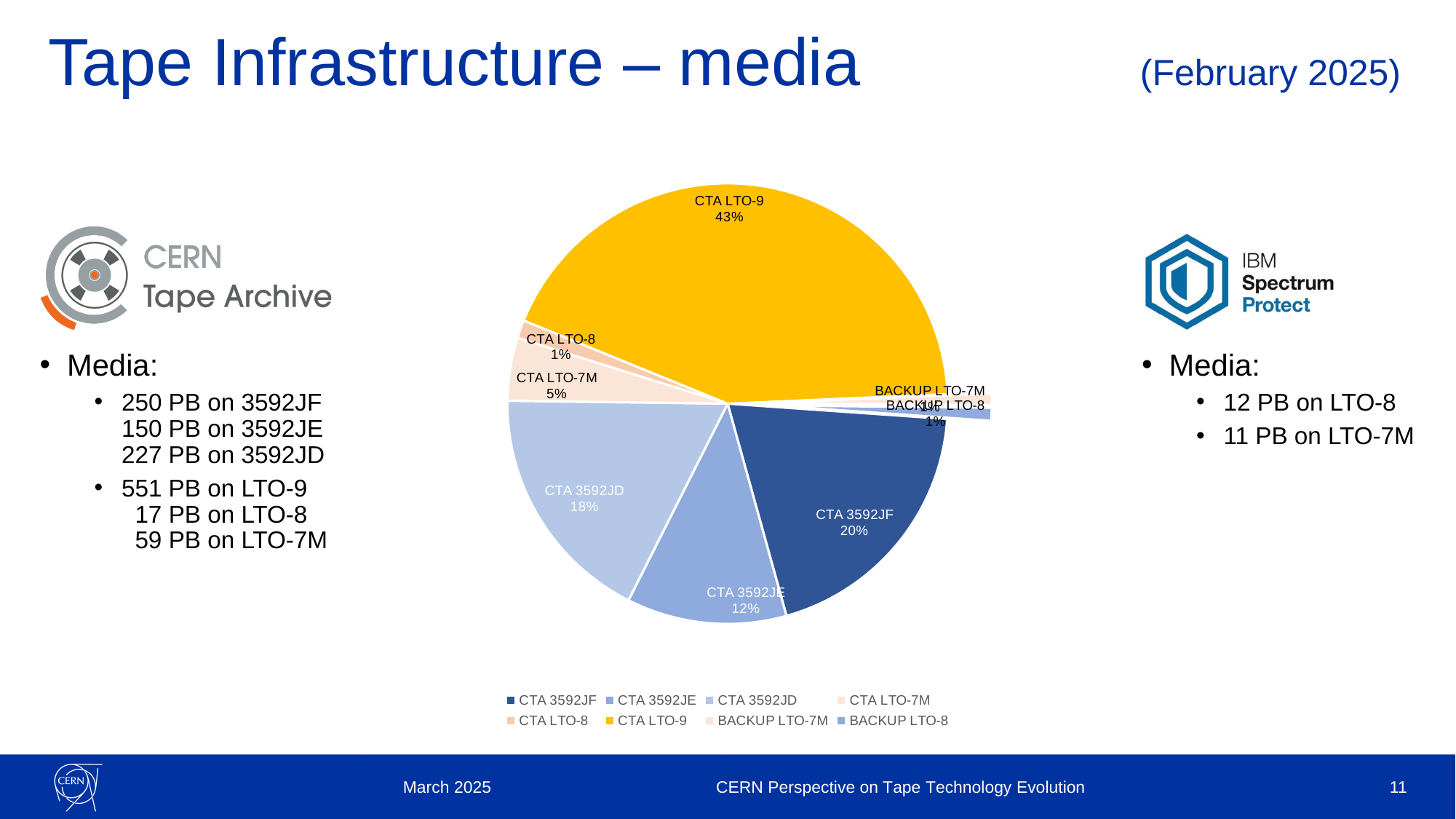
What share of the pie does CTA LTO-9 have? 43% Which slice of the pie chart is the largest? CTA LTO-9 What share of the pie does CTA LTO-7M have? 5% What kind of chart is shown on the slide? pie chart Which slice is larger, CTA 3592JD or CTA 3592JE? CTA 3592JD How many entries does the legend of the pie chart list? 8 What share of the pie does CTA 3592JD have? 18% What colour is the CTA LTO-9 slice in the pie chart? yellow How many slices does the pie chart have? 8 What is the difference in percentage points between the CTA LTO-9 slice and the CTA 3592JF slice? 23